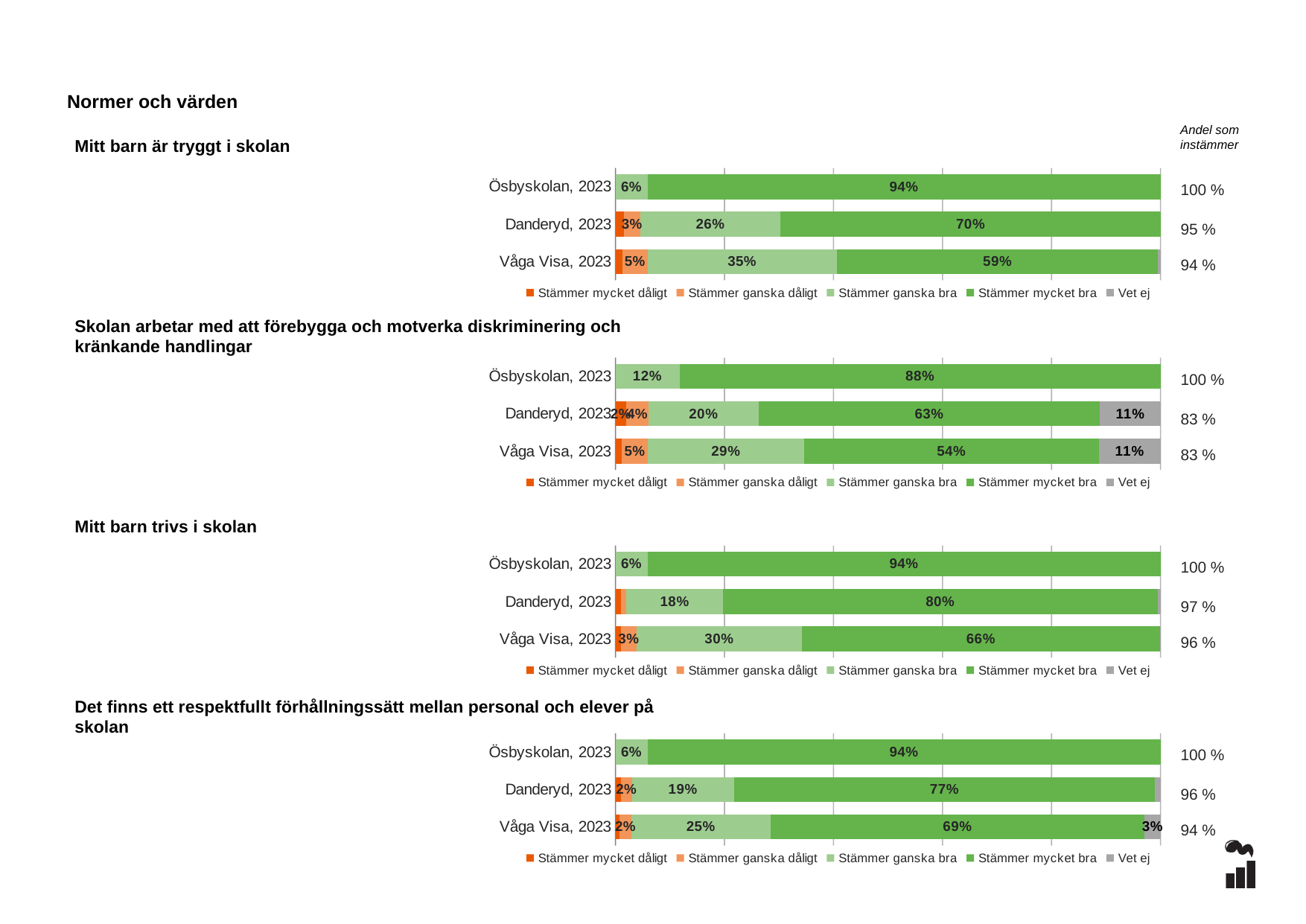
In the chart 'Mitt barn trivs i skolan', which is larger: the 'Stämmer mycket bra' value for Danderyd, 2023 or for Våga Visa, 2023? Danderyd, 2023 In the chart 'Mitt barn är tryggt i skolan', what is the 'Stämmer ganska bra' value for Våga Visa, 2023? 35% In the chart 'Skolan arbetar med att förebygga och motverka diskriminering och kränkande handlingar', what is the difference between the 'Stämmer mycket bra' values for Ösbyskolan, 2023 and Våga Visa, 2023? 34% In the chart 'Mitt barn är tryggt i skolan', which category has the highest 'Stämmer mycket bra' value? Ösbyskolan, 2023 In the chart 'Skolan arbetar med att förebygga och motverka diskriminering och kränkande handlingar', what is the 'Vet ej' value for Danderyd, 2023? 11% In the chart 'Mitt barn är tryggt i skolan', what is the 'Stämmer mycket bra' value for Ösbyskolan, 2023? 94% In the chart 'Det finns ett respektfullt förhållningssätt mellan personal och elever på skolan', what is the 'Andel som instämmer' for Danderyd, 2023? 96 % What kind of chart is 'Mitt barn är tryggt i skolan'? Stacked bar chart How many series does the legend of the chart 'Mitt barn trivs i skolan' list? 5 In the chart 'Mitt barn trivs i skolan', what is the 'Stämmer ganska bra' value for Danderyd, 2023? 18% In the chart 'Det finns ett respektfullt förhållningssätt mellan personal och elever på skolan', what is the 'Stämmer mycket bra' value for Våga Visa, 2023? 69% In the chart 'Skolan arbetar med att förebygga och motverka diskriminering och kränkande handlingar', what is the 'Andel som instämmer' for Danderyd, 2023? 83 %